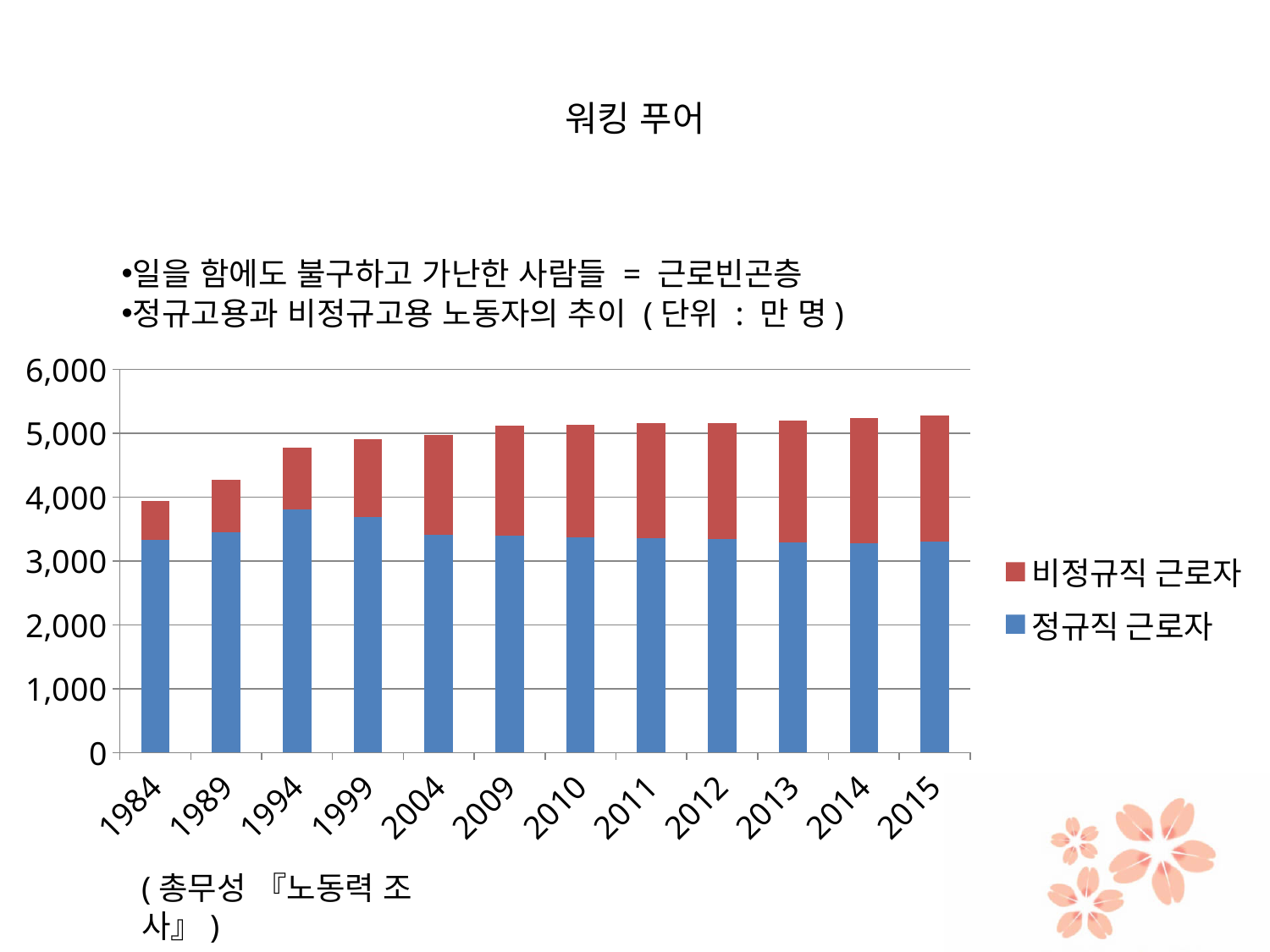
What kind of chart is shown on the slide? Stacked bar chart How many years are shown on the x axis of the chart? 12 Do the total bar heights generally rise or fall from 1984 to 2015? rise Which year has the lowest total bar in the chart? 1984 Is the total bar for 2015 greater or less than 5,000? greater Is the total bar for 1989 greater or less than 4,000? greater How many series does the chart legend list? 2 Which is larger, the total bar for 1984 or the total bar for 2015? 2015 In which year is the 정규직 근로자 value the highest? 1994 Is the total bar for 1999 greater or less than 5,000? less What colour represents 비정규직 근로자 in the chart? Red